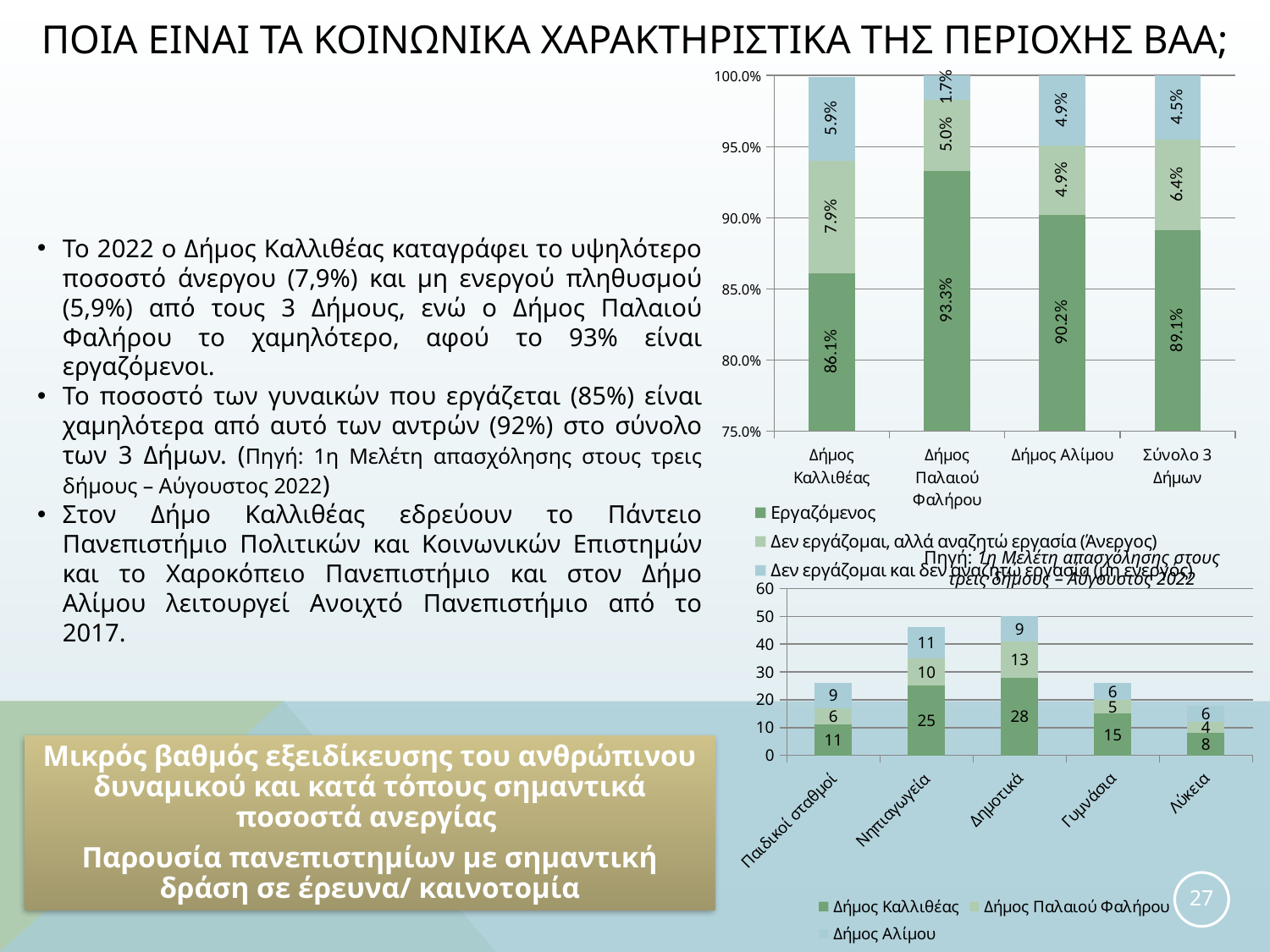
How many series does the legend of the top chart list? 3 In the bottom chart, what is the total of the stacked bar for Δημοτικά? 50 What kind of chart is the bottom chart? Stacked bar chart In the top chart, which category has the lowest value for Δεν εργάζομαι και δεν αναζητώ εργασία (μη ενεργός)? Δήμος Παλαιού Φαλήρου How many categories are shown on the x axis of the bottom chart? 5 In the bottom chart, which is larger: Δήμος Παλαιού Φαλήρου in Γυμνάσια or Δήμος Αλίμου in Γυμνάσια? Δήμος Αλίμου In the bottom chart, what is the value for Δήμος Αλίμου in Νηπιαγωγεία? 11 In the top chart, what is the value for Δεν εργάζομαι, αλλά αναζητώ εργασία (Άνεργος) in Δήμος Καλλιθέας? 7.9% In the bottom chart, what is the value for Δήμος Καλλιθέας in Δημοτικά? 28 In the top chart, what is the difference between the Εργαζόμενος values for Δήμος Παλαιού Φαλήρου and Δήμος Καλλιθέας? 7.2% In the top chart, which category has the highest Εργαζόμενος value? Δήμος Παλαιού Φαλήρου In the top chart, what is the value for Εργαζόμενος in Δήμος Παλαιού Φαλήρου? 93.3%